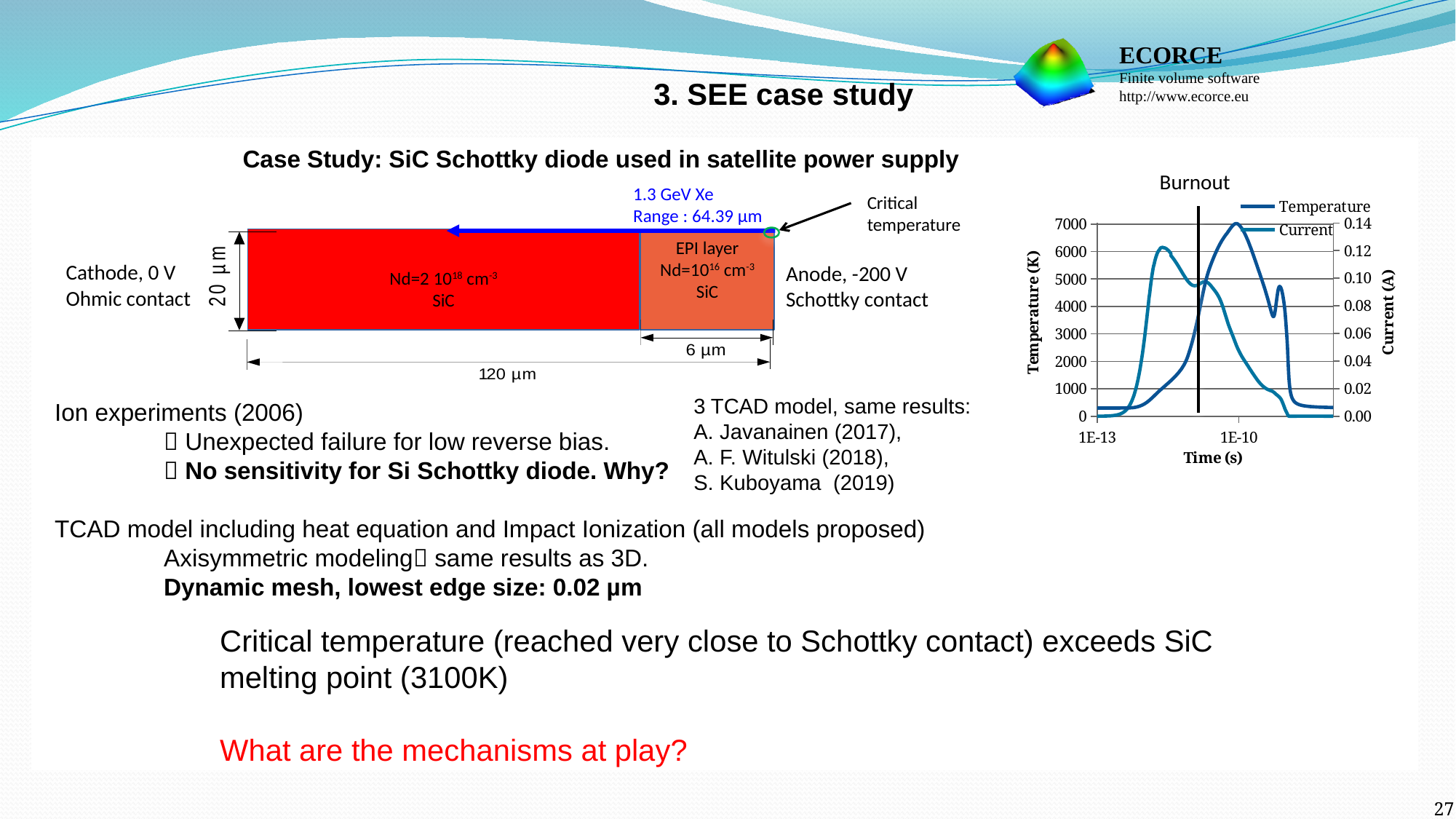
In the "Burnout" chart, is the Temperature value at the right end of the time axis greater or less than 1000? less What are the two series named in the legend of the "Burnout" chart? Temperature and Current In the "Burnout" chart, is the Current value at the right end of the time axis greater or less than 0.02? less In the "Burnout" chart, is the peak value of the Temperature series greater or less than 6000? greater How many series does the legend of the "Burnout" chart list? 2 What kind of chart is the "Burnout" chart? line chart In the "Burnout" chart, does the Temperature series rise and then fall, or fall and then rise, along the time axis? rise and then fall What is the title of the chart on the right of the slide? Burnout In the "Burnout" chart, which series reaches its peak earlier in time, Temperature or Current? Current